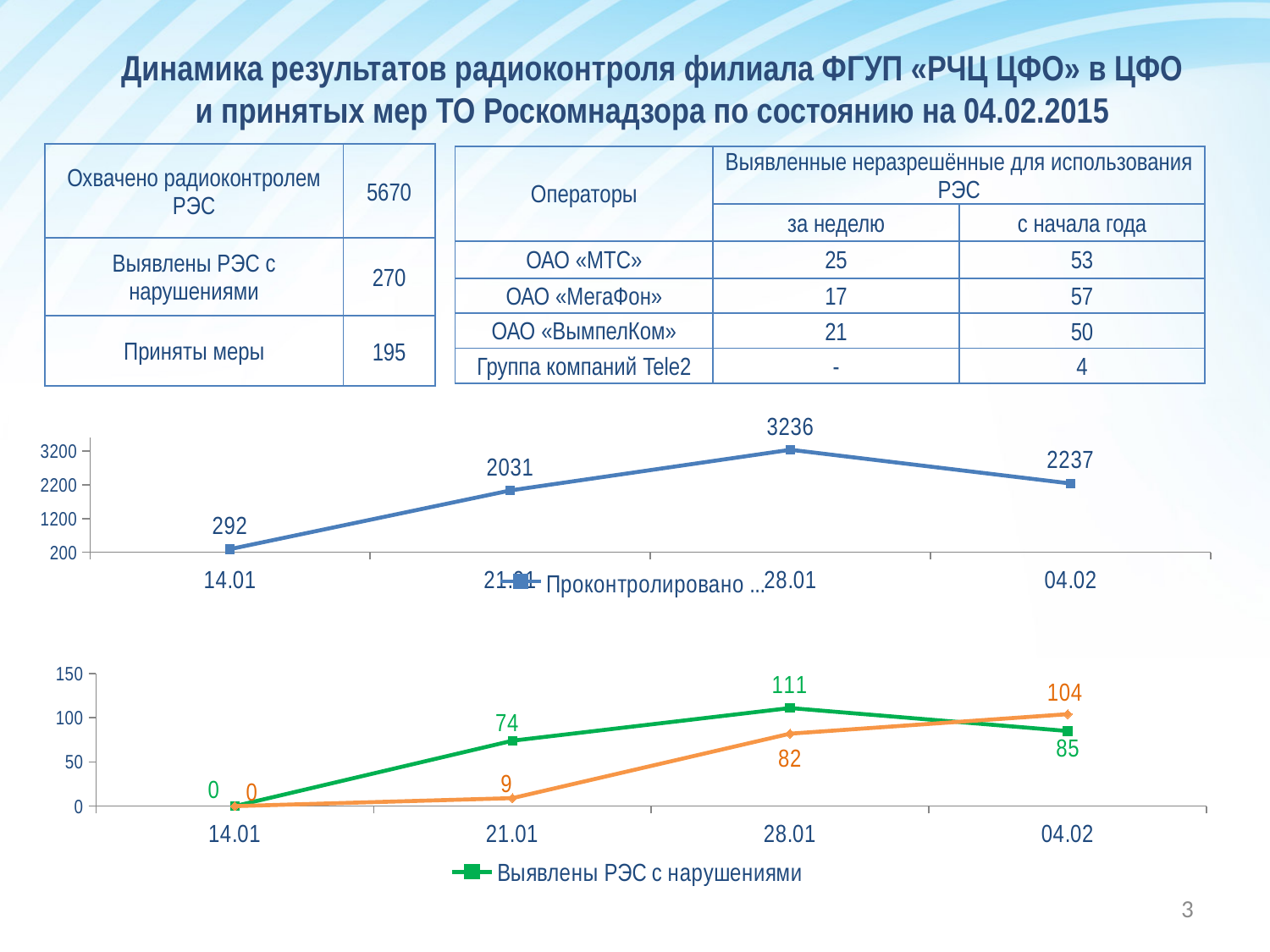
In the upper chart, what is the value for 14.01? 292 In the upper chart, what is the difference between the values for 28.01 and 04.02? 999 What kind of chart is the lower chart? line chart In the lower chart, what is the value of the series 'Выявлены РЭС с нарушениями' for 21.01? 74 In the lower chart, what is the difference between the green line's values for 28.01 and 04.02? 26 In the lower chart, which is larger at 04.02: the green line or the orange line? the orange line In the upper chart, what is the value for 28.01? 3236 In the lower chart, what is the value of the series 'Выявлены РЭС с нарушениями' for 28.01? 111 In the upper chart, which date has the lowest value? 14.01 In the upper chart, how many data points are plotted? 4 In the lower chart, does the series 'Выявлены РЭС с нарушениями' rise or fall between 28.01 and 04.02? fall In the upper chart, which date has the highest value? 28.01